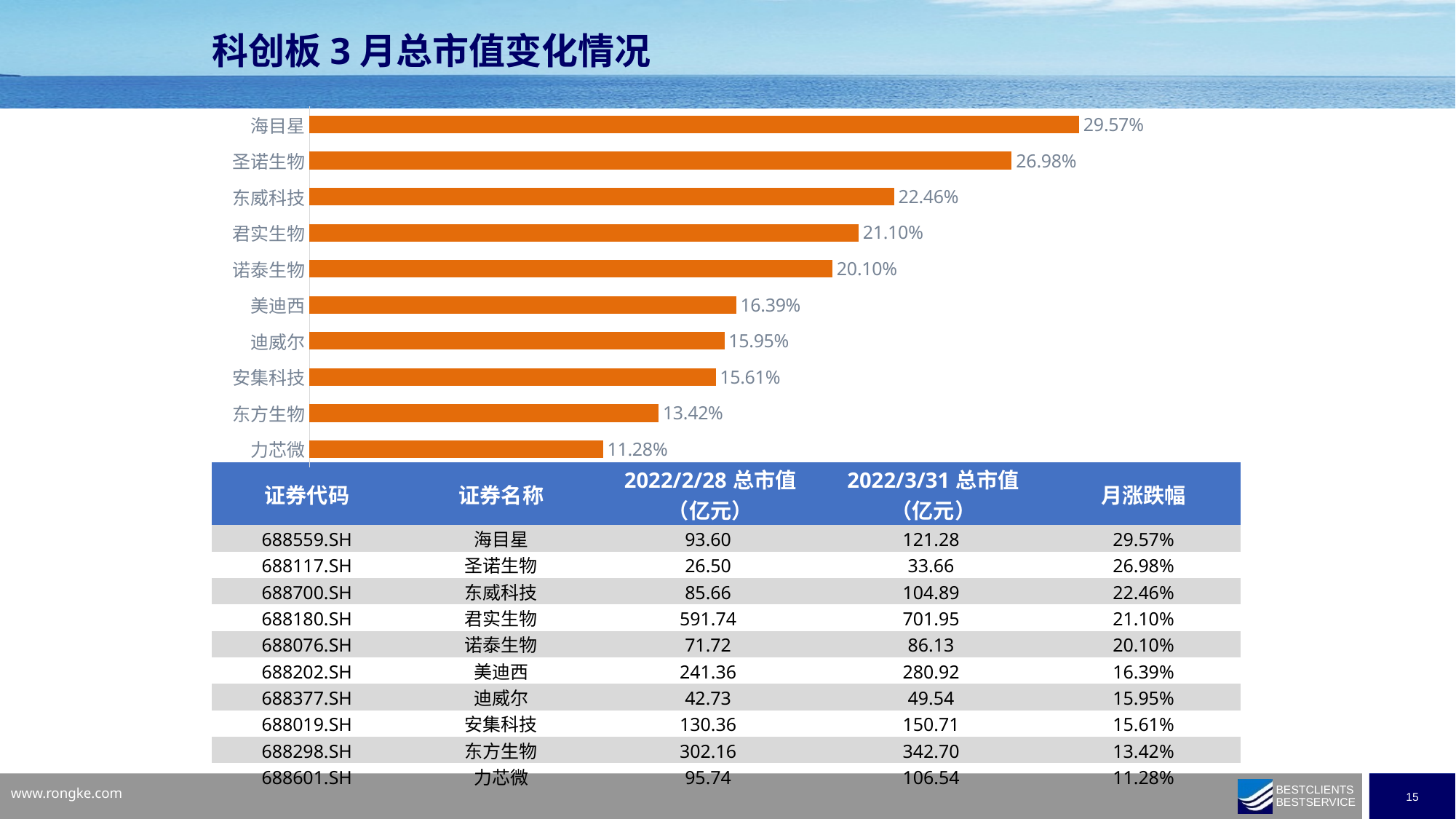
What is the value shown for 海目星 in the bar chart? 29.57% What is the value shown for 安集科技 in the bar chart? 15.61% What is the difference between the values for 圣诺生物 and 东威科技 in the bar chart? 4.52% Which has a larger value in the bar chart, 君实生物 or 美迪西? 君实生物 How many categories are shown in the bar chart? 10 What is the difference between the values for 海目星 and 力芯微 in the bar chart? 18.29% What is the value shown for 诺泰生物 in the bar chart? 20.10% Which has a larger value in the bar chart, 东方生物 or 迪威尔? 迪威尔 What colour are the bars in the chart? Orange Which category has the highest value in the bar chart? 海目星 Which category has the lowest value in the bar chart? 力芯微 What kind of chart is shown on the slide? Bar chart